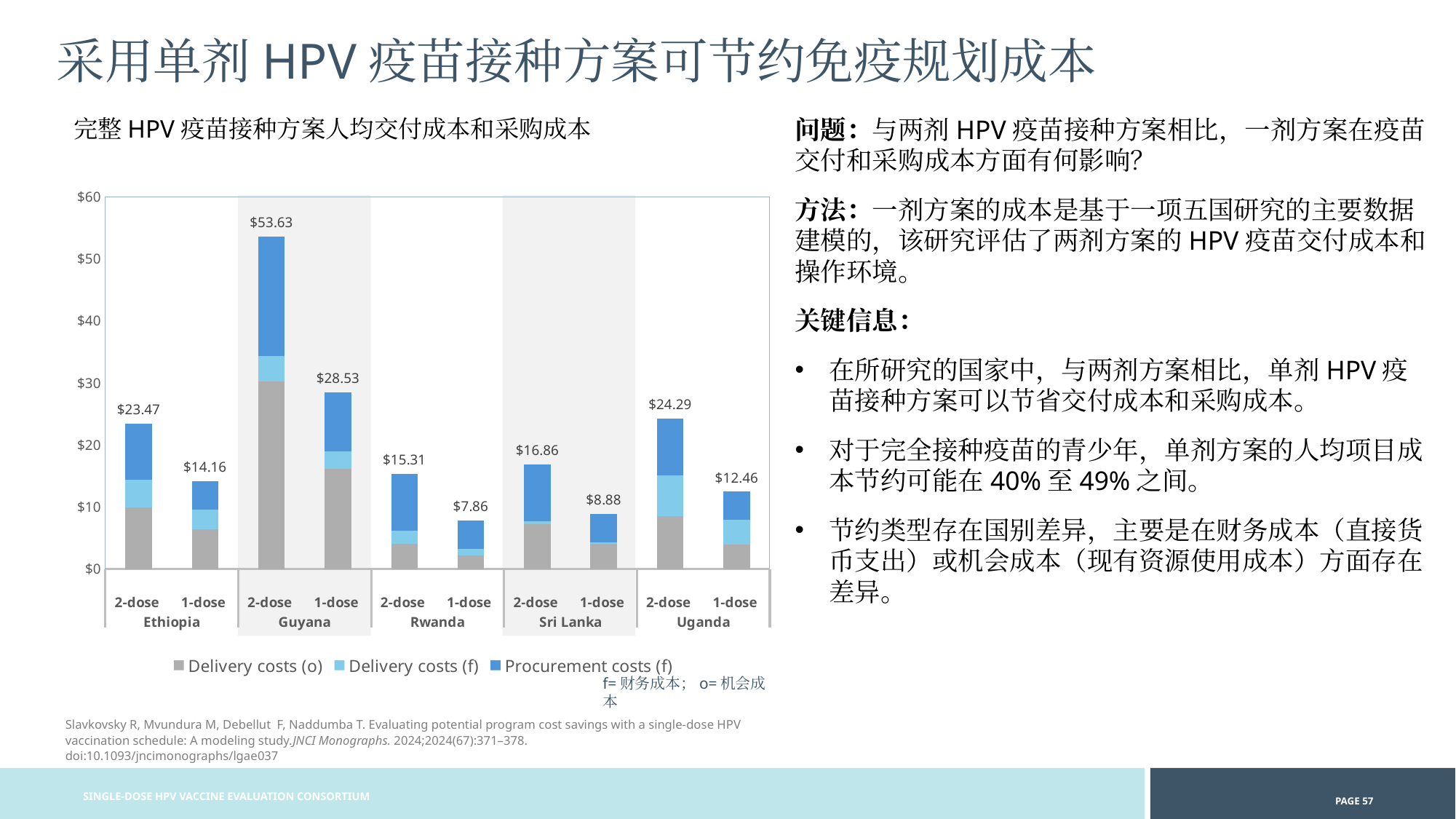
Which is larger, the 1-dose total cost in Sri Lanka or the 1-dose total cost in Rwanda? Sri Lanka 1-dose Which bar has the highest total cost? Guyana 2-dose How many series does the legend list? 3 Which bar has the lowest total cost? Rwanda 1-dose Is the Delivery costs (o) segment for the Guyana 1-dose bar greater or less than $10? greater What is the difference between the 2-dose and 1-dose total costs in Guyana? $25.10 What is the total per-person cost for the 2-dose schedule in Guyana? $53.63 What is the difference between the 2-dose and 1-dose total costs in Ethiopia? $9.31 What kind of chart is shown on the slide? Stacked bar chart What is the total per-person cost for the 1-dose schedule in Rwanda? $7.86 What is the total per-person cost for the 1-dose schedule in Uganda? $12.46 How many countries are shown on the x axis? 5